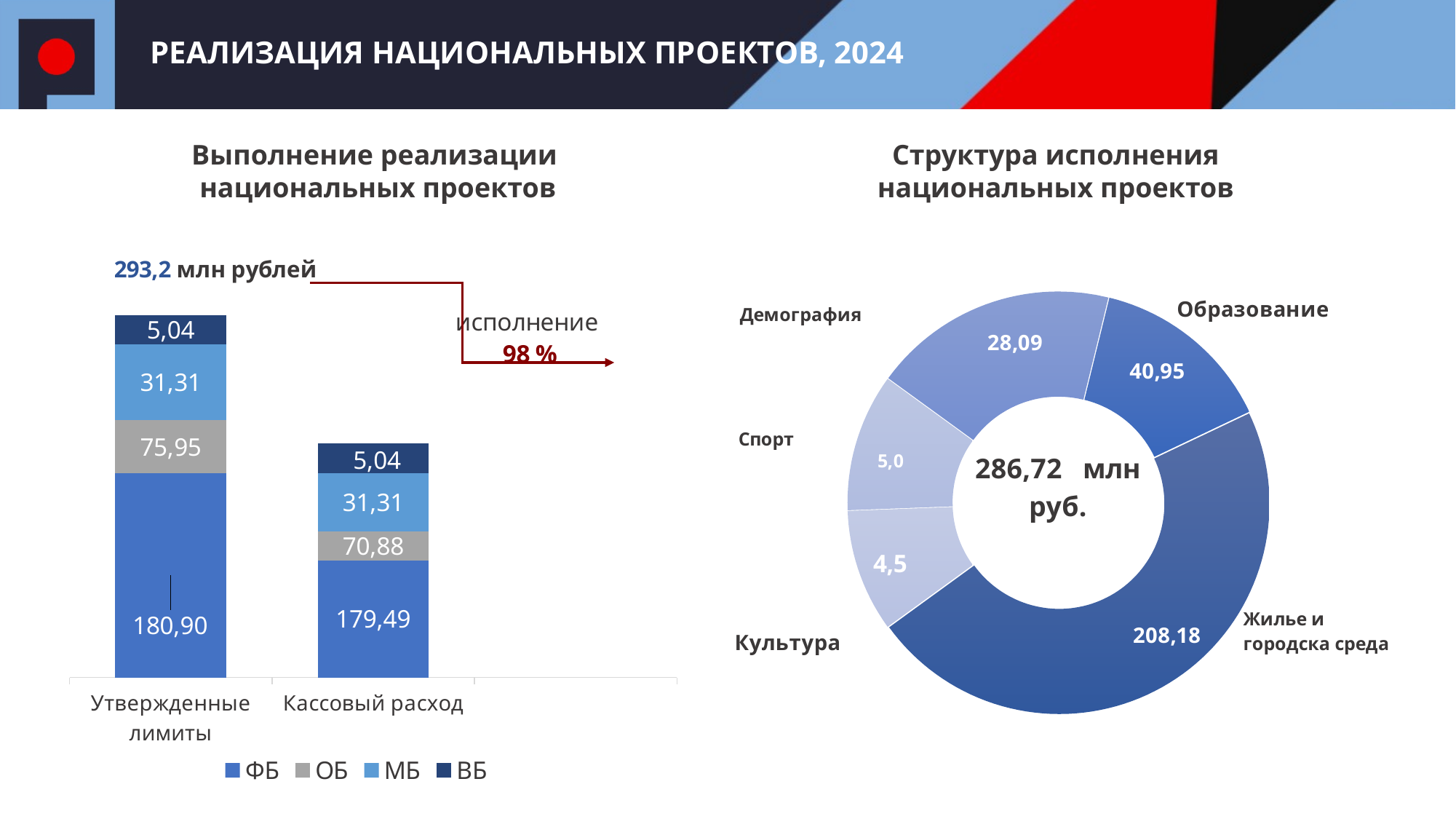
What kind of chart is the right chart, 'Структура исполнения национальных проектов'? Doughnut (pie) chart What kind of chart is the left chart, 'Выполнение реализации национальных проектов'? Stacked bar chart In the left chart 'Выполнение реализации национальных проектов', what is the difference between the ОБ values for 'Утвержденные лимиты' and 'Кассовый расход'? 5,07 In the right chart 'Структура исполнения национальных проектов', which category has the smallest value? Культура In the left chart 'Выполнение реализации национальных проектов', what is the ФБ value for 'Утвержденные лимиты'? 180,90 In the left chart 'Выполнение реализации национальных проектов', what is the total of the 'Кассовый расход' stacked bar? 286,72 In the right chart 'Структура исполнения национальных проектов', what is the value for 'Образование'? 40,95 In the left chart 'Выполнение реализации национальных проектов', how many series does the legend list? 4 In the left chart 'Выполнение реализации национальных проектов', which series is the largest segment in the 'Утвержденные лимиты' bar? ФБ In the right chart 'Структура исполнения национальных проектов', which category has the largest value? Жилье и городска среда In the left chart 'Выполнение реализации национальных проектов', what is the ОБ value for 'Кассовый расход'? 70,88 In the right chart 'Структура исполнения национальных проектов', how many categories are shown? 5